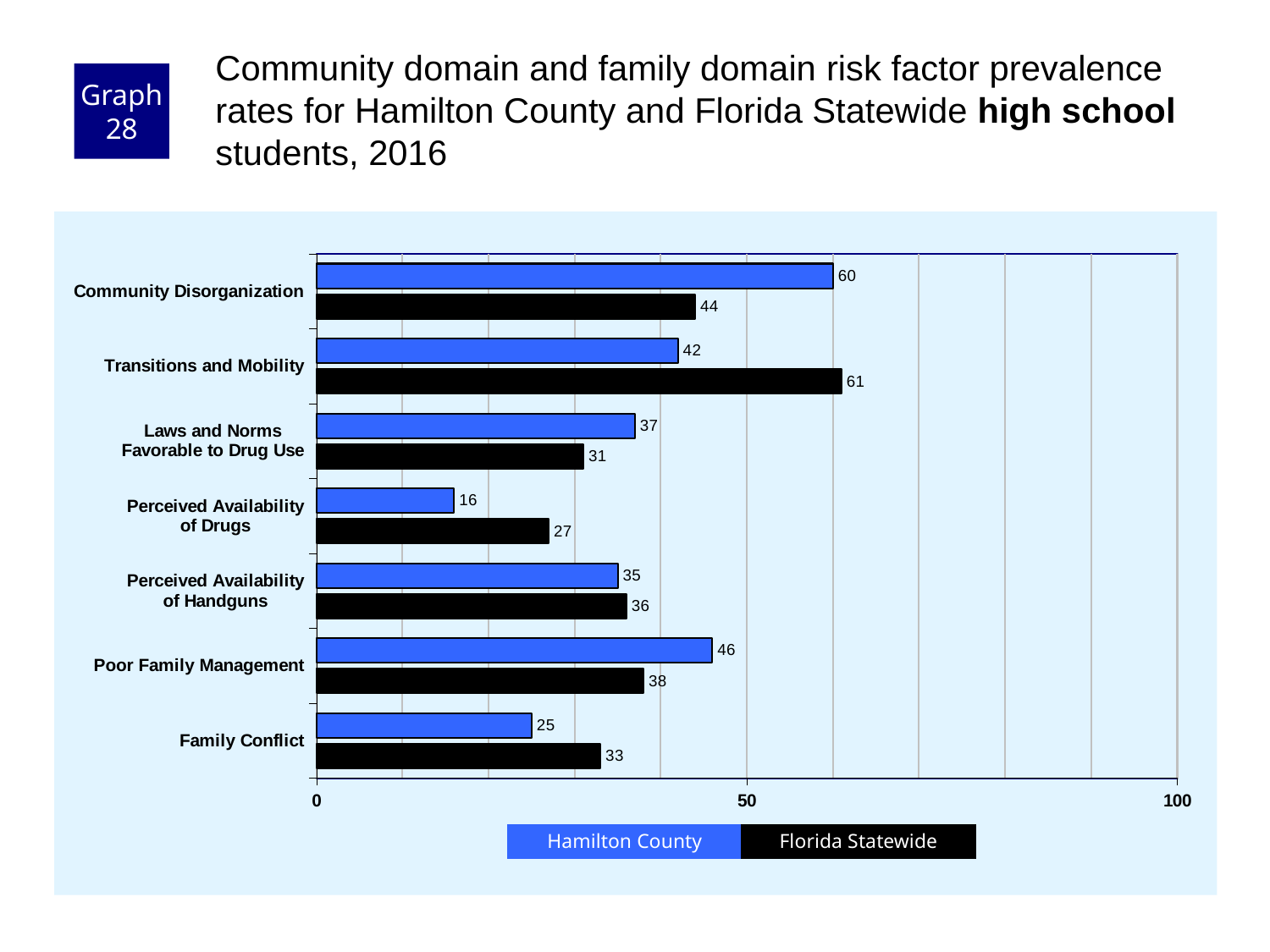
What is the Hamilton County value for Perceived Availability of Drugs? 16 How many risk factors are shown on the chart? 7 Is the Hamilton County value for Community Disorganization greater or less than 50? greater What is the difference between the Hamilton County and Florida Statewide values for Poor Family Management? 8 Which risk factor has the highest Hamilton County value? Community Disorganization What is the Florida Statewide value for Transitions and Mobility? 61 What kind of chart is shown on the slide? Bar chart How many series does the legend list? 2 Which risk factor has the lowest Florida Statewide value? Perceived Availability of Drugs Which is larger for Family Conflict: the Hamilton County value or the Florida Statewide value? Florida Statewide Which colour represents Florida Statewide in the chart? Black What is the Hamilton County value for Community Disorganization? 60